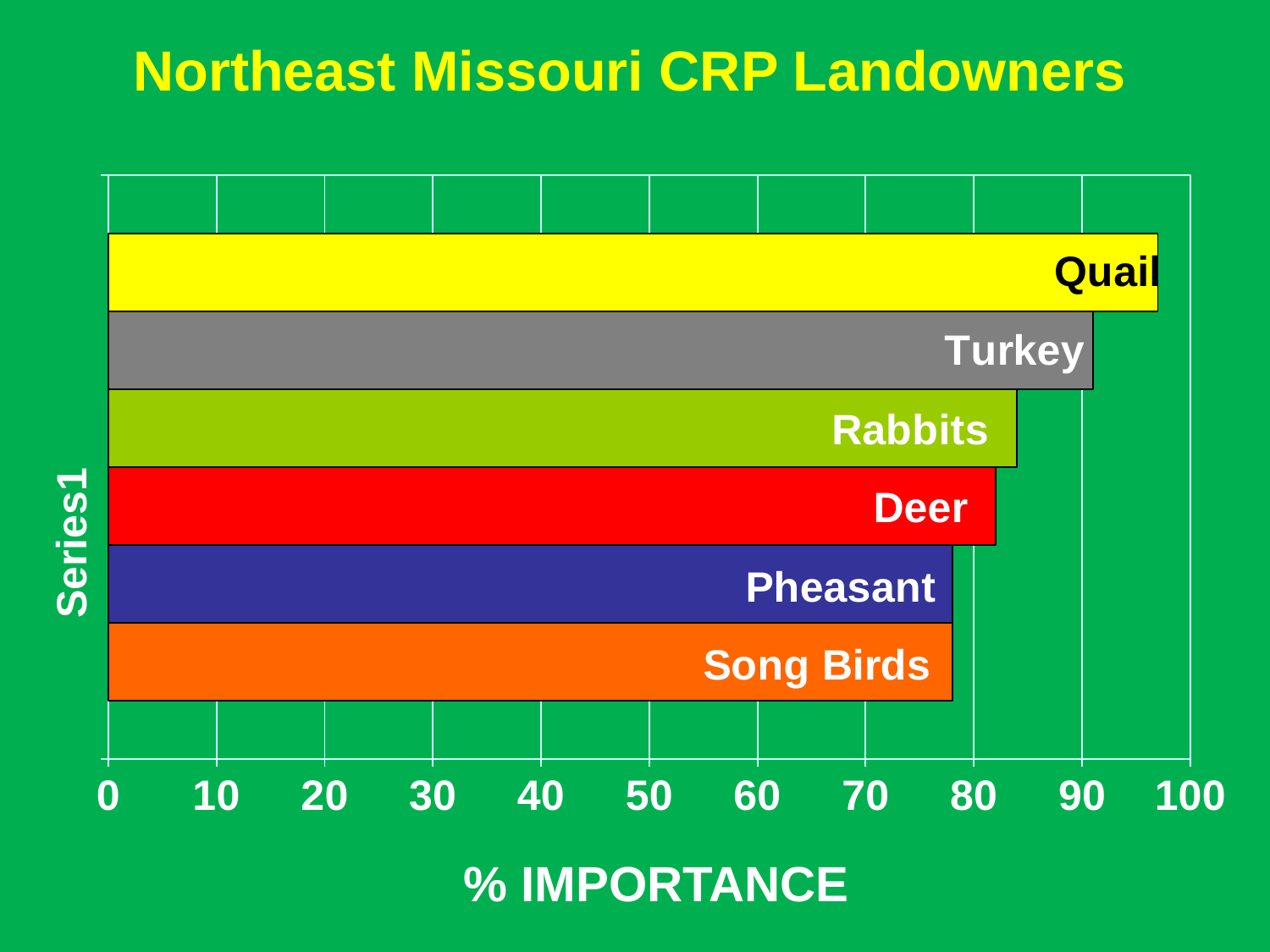
How many categories (bars) are shown in the chart? 6 Is the value for Song Birds greater or less than 80? less Is the value for Turkey greater or less than 100? less Is the value for Rabbits greater or less than 80? greater Which category has the highest % importance? Quail Which has a larger % importance, Rabbits or Pheasant? Rabbits Which has a larger % importance, Quail or Turkey? Quail What kind of chart is shown on the slide? bar chart What is the title of the chart? Northeast Missouri CRP Landowners What is the label on the horizontal axis? % IMPORTANCE